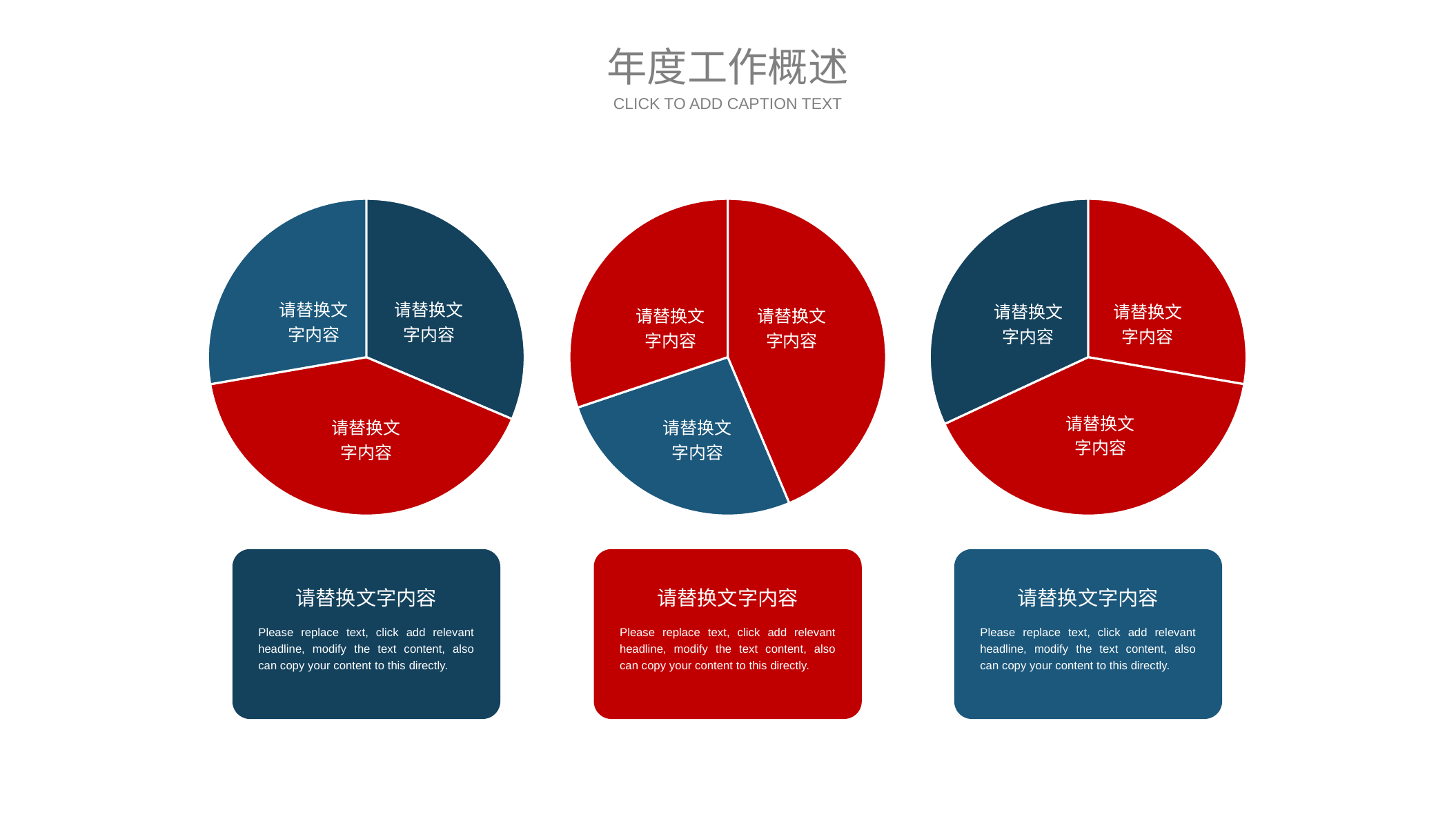
What kind of chart is shown in the middle of the slide? Pie chart How many slices does the middle pie chart have? 3 How many pie charts are on the slide? 3 What kind of chart is shown on the right of the slide? Pie chart In the middle pie chart, how many slices are coloured red? 2 In the middle pie chart, which slice is the largest: the right red slice, the top-left red slice, or the blue slice? The right red slice In the left pie chart, what colour is the bottom slice? Red How many slices does the right pie chart have? 3 What kind of chart is shown on the left of the slide? Pie chart